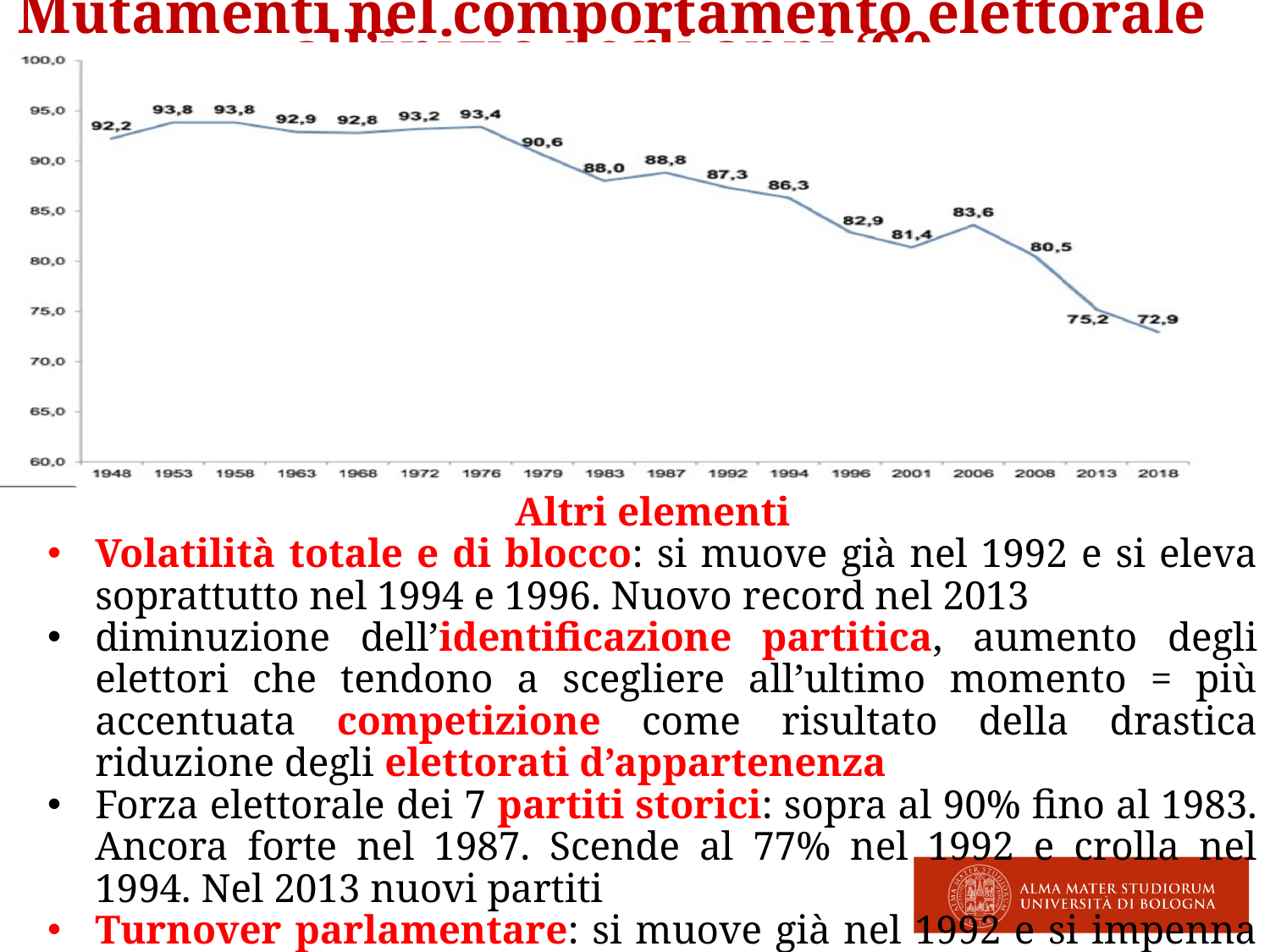
What is the value plotted for 2013? 75,2 What type of chart is shown on the slide? line chart How many data points are plotted on the chart? 18 What is the highest value shown on the chart? 93,8 Do the values generally rise or fall from 1948 to 2018? fall What is the value plotted for 1948? 92,2 Which is larger, the value for 1983 or the value for 1987? 1987 What is the difference between the values for 2013 and 2018? 2,3 What is the value plotted for 1979? 90,6 What is the value plotted for 2006? 83,6 Which year has the lowest value on the chart? 2018 What is the difference between the values for 1976 and 1979? 2,8